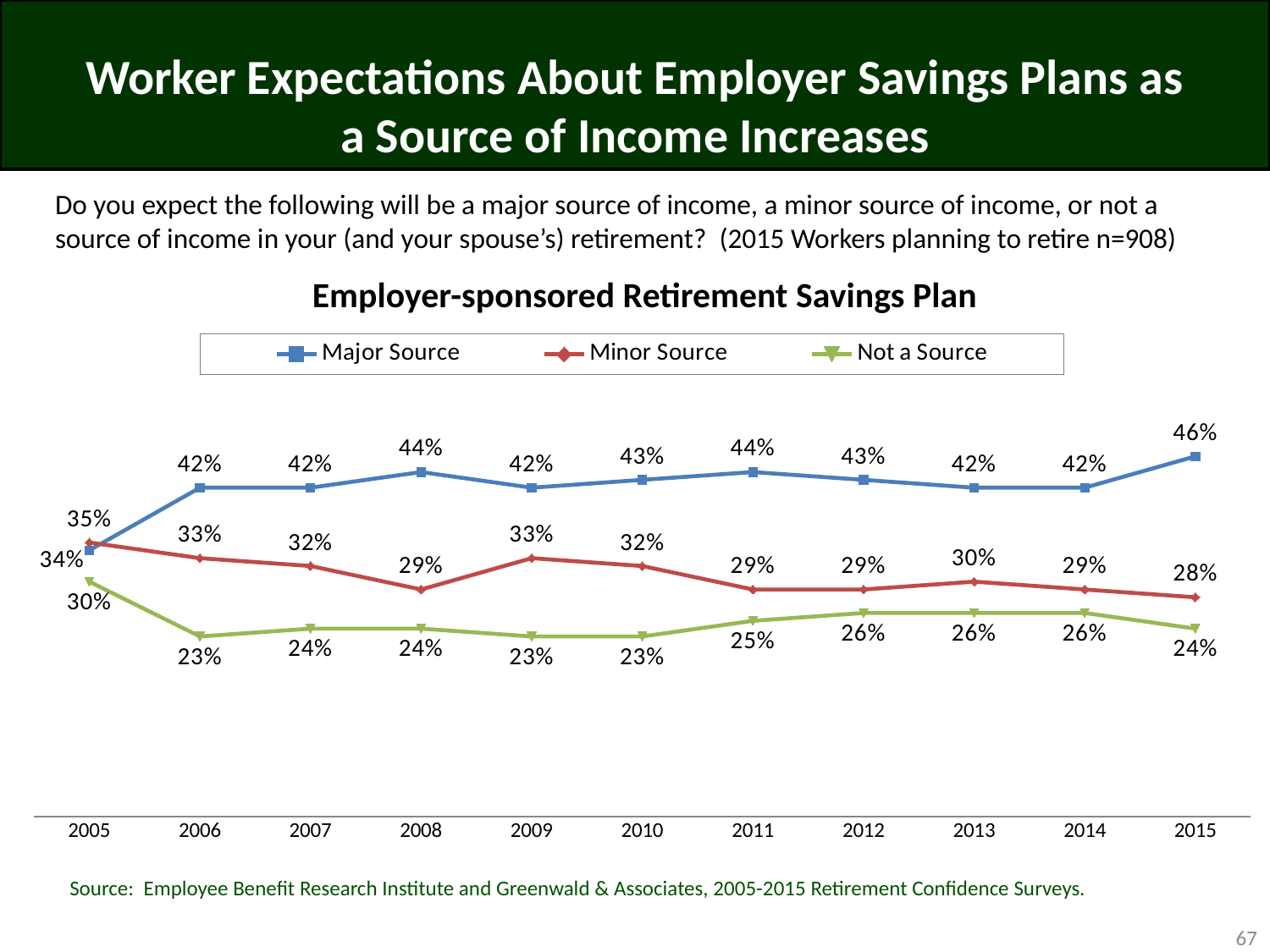
What is the Minor Source value for 2008? 29% In which year was the Major Source value highest? 2015 Did the Minor Source value rise or fall from 2005 to 2015? Fall What is the difference between the Major Source and Minor Source values in 2015? 18 percentage points In which year was the Major Source value lowest? 2005 How many series does the legend list? 3 What kind of chart is shown on the slide? Line chart Which was larger in 2005, the Major Source value or the Minor Source value? Minor Source What percentage of workers said an employer-sponsored retirement savings plan would be a major source of income in 2015? 46% What is the title of the chart? Employer-sponsored Retirement Savings Plan What is the Not a Source value for 2012? 26% How many years are shown on the x axis? 11